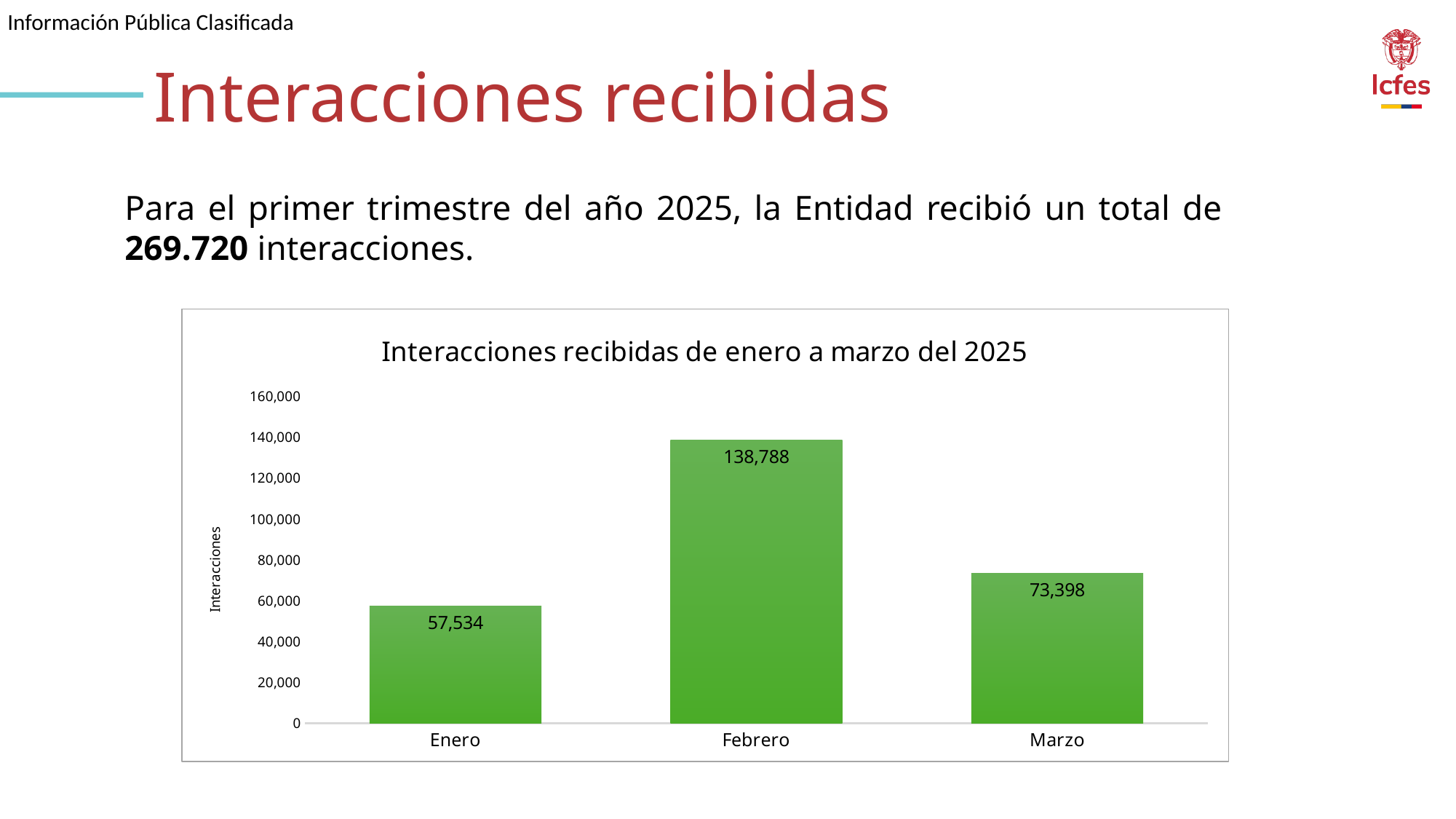
Is the value for Febrero greater or less than 120,000? greater What is the value for Febrero? 138,788 What is the difference between the values for Marzo and Enero? 15,864 Which month has the highest number of interactions? Febrero Which is larger, the value for Enero or the value for Marzo? Marzo What kind of chart is shown on the slide? Bar chart What is the difference between the values for Febrero and Marzo? 65,390 How many months are shown on the chart? 3 What is the title of the chart? Interacciones recibidas de enero a marzo del 2025 Which month has the lowest number of interactions? Enero What is the value for Marzo? 73,398 What is the value for Enero? 57,534